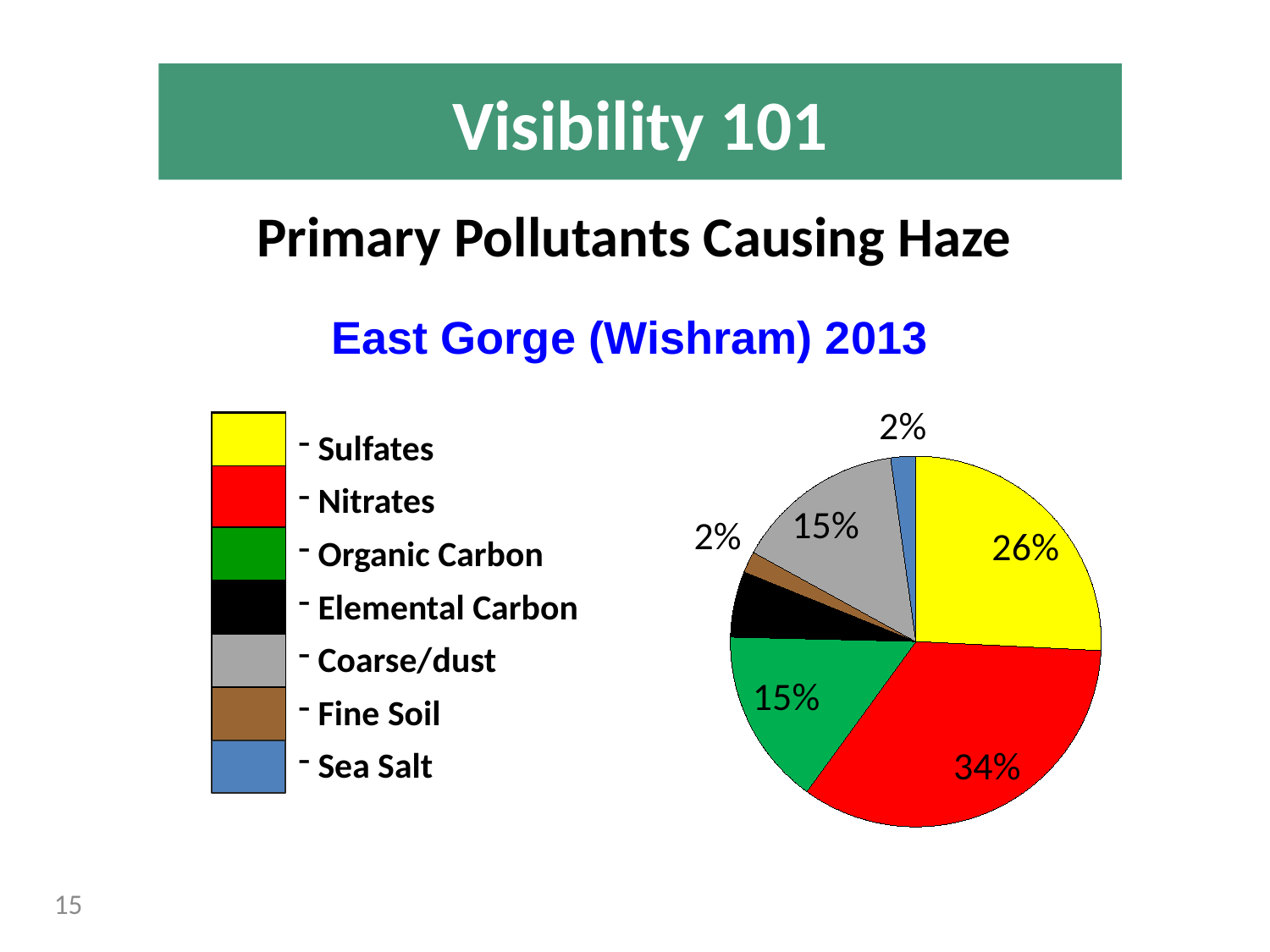
What kind of chart is shown on the slide? Pie chart What share of the pie is Nitrates? 34% Which pollutant has the largest slice of the pie? Nitrates What share of the pie is Fine Soil? 2% What share of the pie is Coarse/dust? 15% What share of the pie is Organic Carbon? 15% What colour represents Nitrates in the pie chart? Red Which slice is larger, Sulfates or Organic Carbon? Sulfates What share of the pie is Sulfates? 26% How many pollutant categories does the legend list? 7 How many percentage points larger is the Nitrates slice than the Sulfates slice? 8 What share of the pie is Sea Salt? 2%